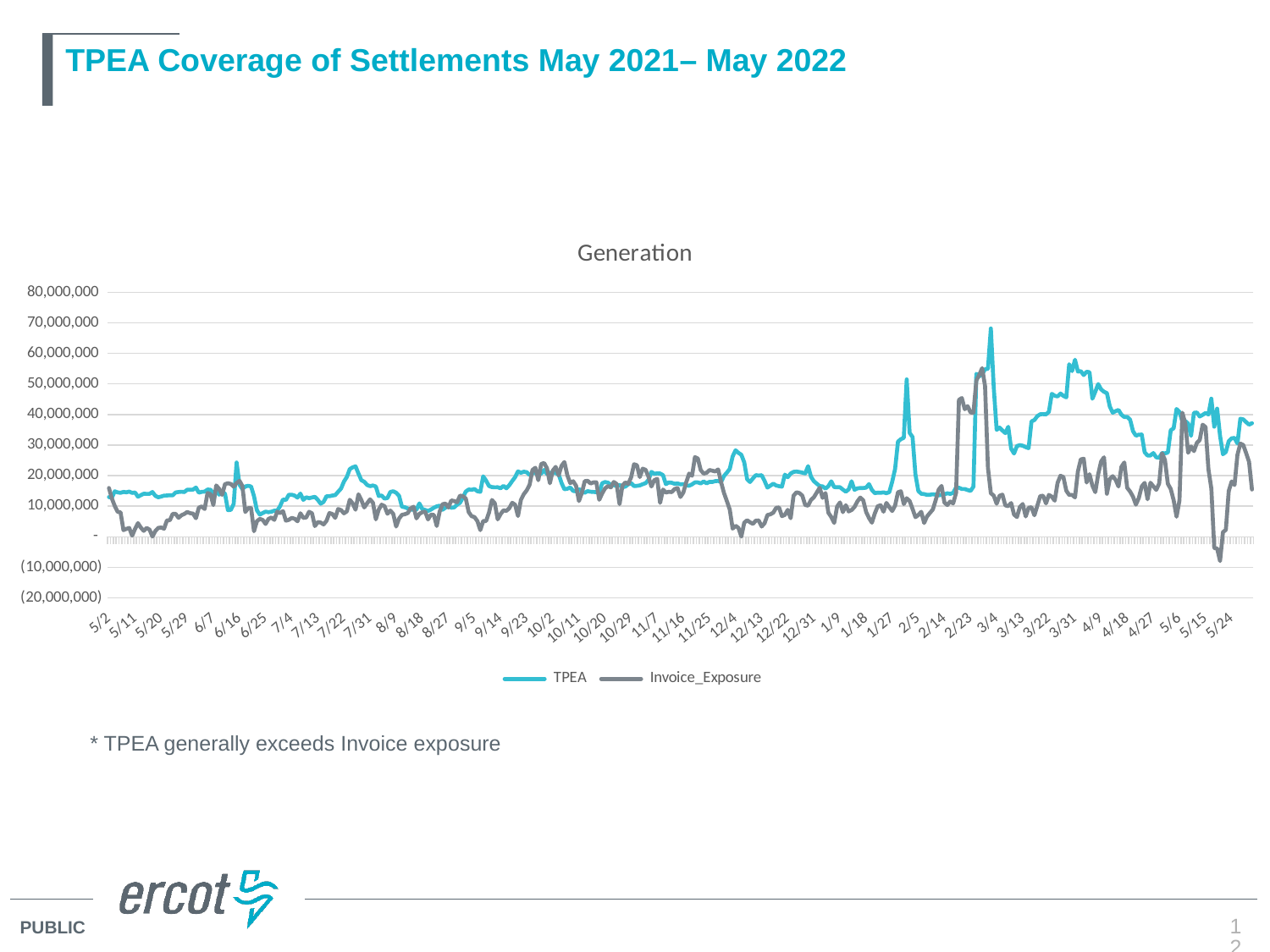
What are the two series named in the legend? TPEA and Invoice_Exposure What is the title of the chart? Generation Is the value of TPEA at 5/2 greater or less than 20,000,000? less Around 3/31, which series has the larger value, TPEA or Invoice_Exposure? TPEA Is the peak value of TPEA (around 3/4) greater or less than 60,000,000? greater What kind of chart is shown on the slide? Line chart Around 12/4, which series has the larger value, TPEA or Invoice_Exposure? TPEA Which series reaches the lowest value on the chart? Invoice_Exposure Is the lowest value of Invoice_Exposure (around 5/15) greater or less than 0? less Which series reaches the highest value on the chart? TPEA How many series does the legend list? 2